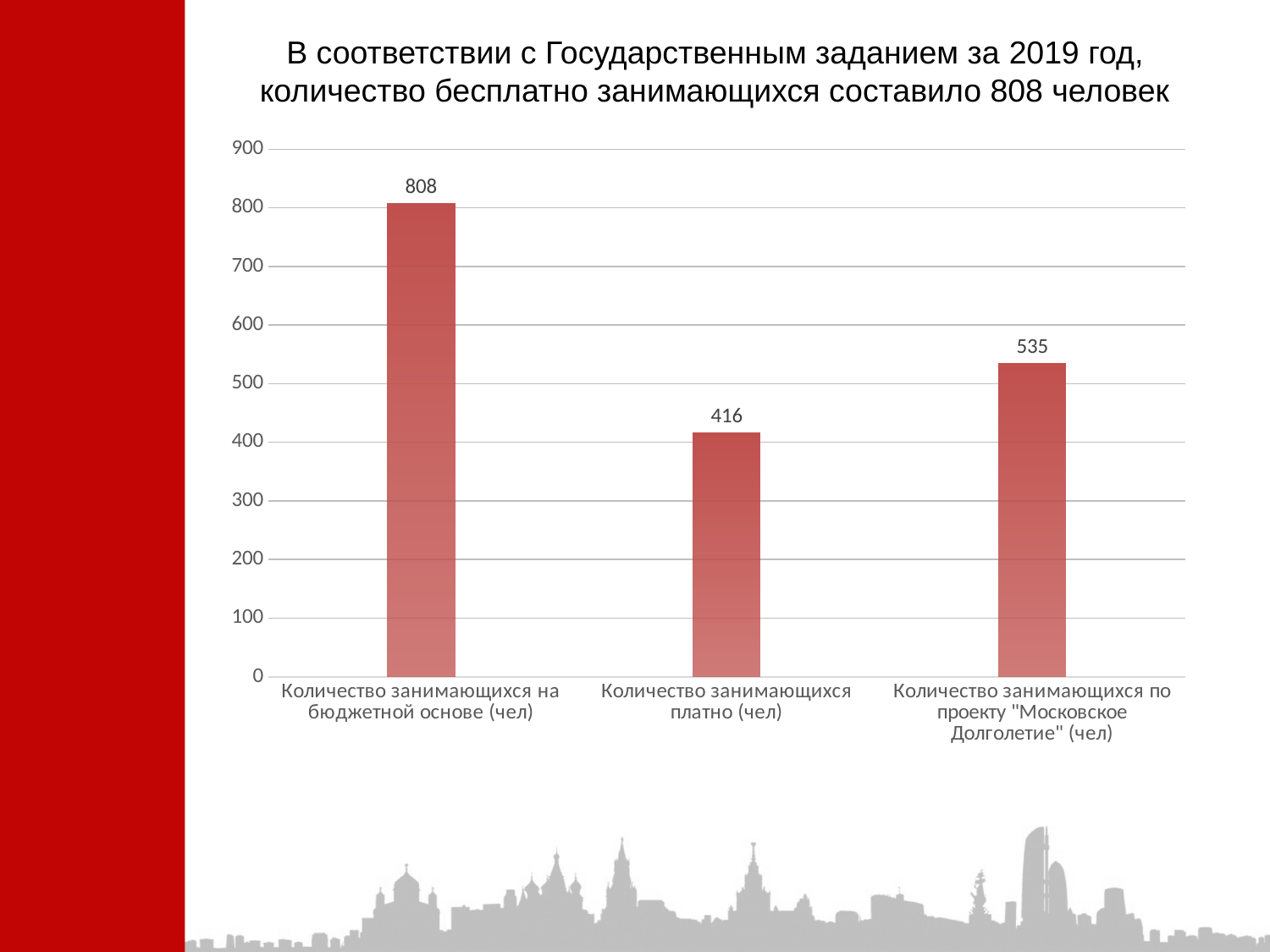
What is the value for "Количество занимающихся платно (чел)"? 416 Which category has the lowest value? Количество занимающихся платно (чел) What is the value for "Количество занимающихся на бюджетной основе (чел)"? 808 Is the value for "Количество занимающихся по проекту "Московское Долголетие" (чел)" greater or less than 500? greater What is the highest value shown on the vertical axis? 900 What is the value for "Количество занимающихся по проекту "Московское Долголетие" (чел)"? 535 What is the difference between the value for "Количество занимающихся по проекту "Московское Долголетие" (чел)" and the value for "Количество занимающихся платно (чел)"? 119 What is the difference between the value for "Количество занимающихся на бюджетной основе (чел)" and the value for "Количество занимающихся платно (чел)"? 392 Which is larger: the value for "Количество занимающихся платно (чел)" or the value for "Количество занимающихся по проекту "Московское Долголетие" (чел)"? Количество занимающихся по проекту "Московское Долголетие" (чел) What kind of chart is shown on the slide? bar chart Which category has the highest value? Количество занимающихся на бюджетной основе (чел) How many categories are shown in the chart? 3